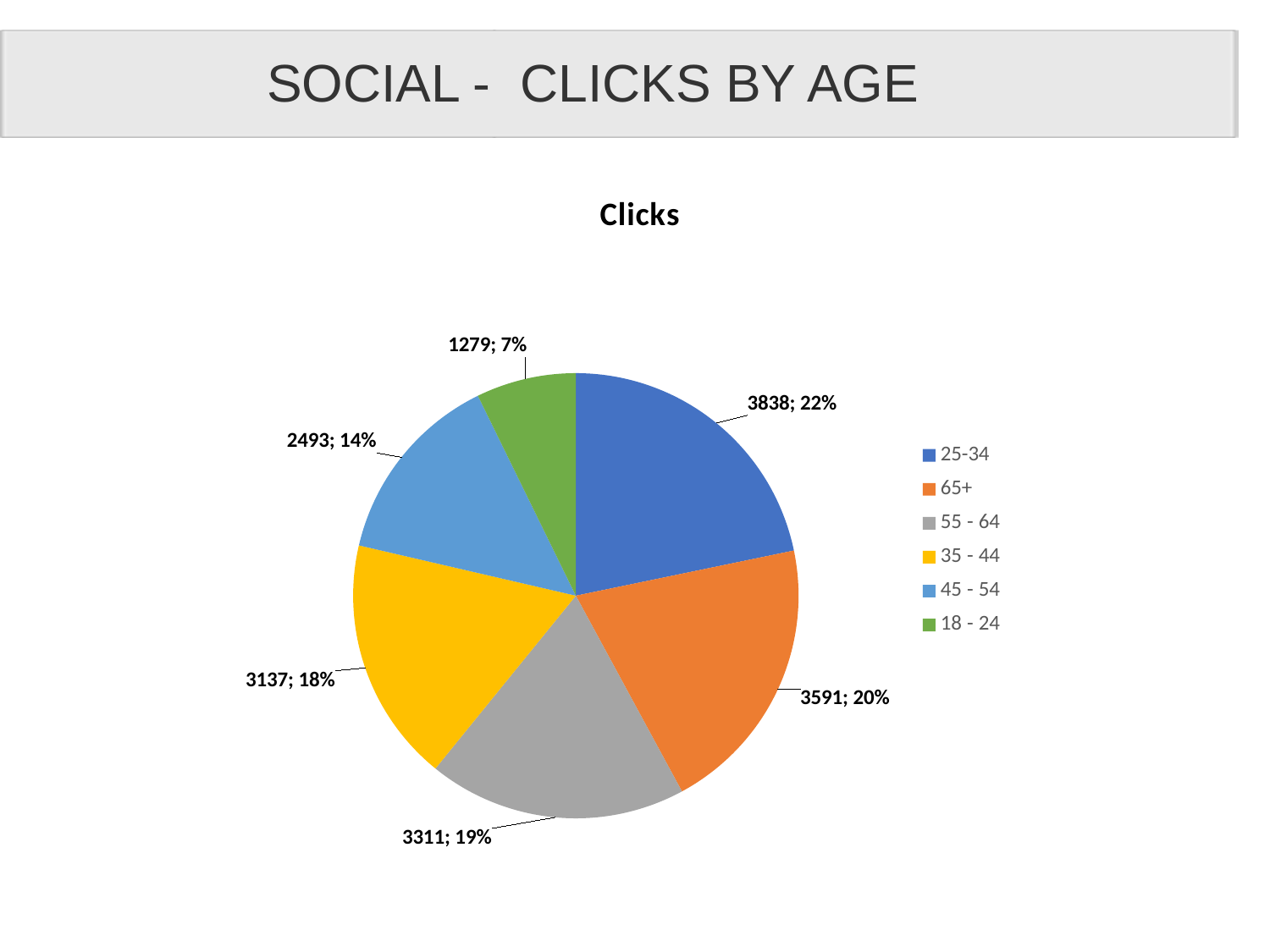
How many clicks are shown for the 25-34 age group? 3838 What type of chart is shown on the slide? pie chart How many clicks are shown for the 65+ age group? 3591 Which age group has the lowest number of clicks? 18 - 24 What is the title of the chart? Clicks How many slices does the pie chart have? 6 Which has more clicks, the 55 - 64 age group or the 35 - 44 age group? 55 - 64 What share of the pie does the 35 - 44 age group represent? 18% How many clicks are shown for the 18 - 24 age group? 1279 What is the difference in clicks between the 25-34 and 65+ age groups? 247 Which age group has the highest number of clicks? 25-34 What share of the pie does the 45 - 54 age group represent? 14%